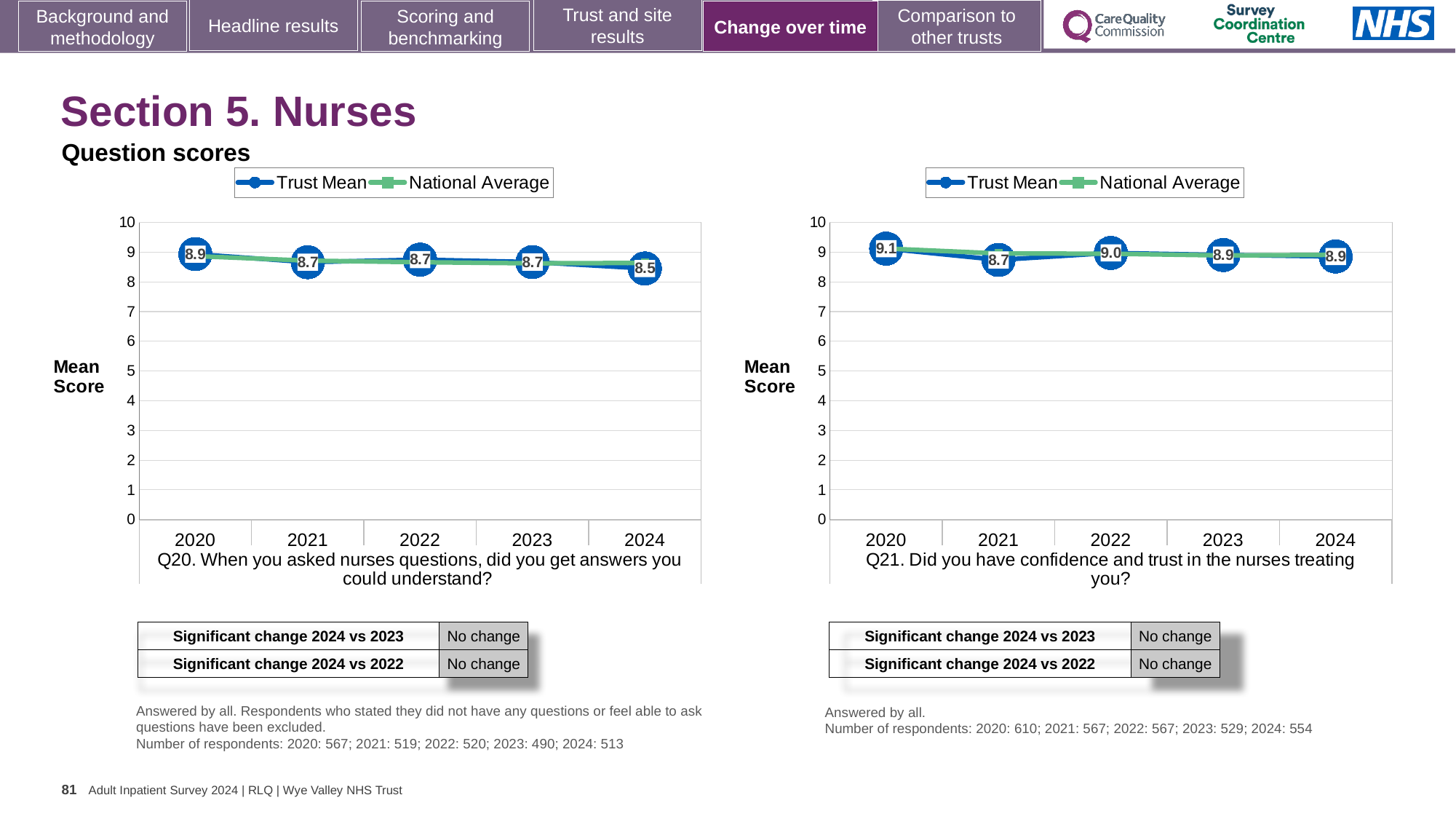
On the Q20 chart (left), what is the Trust Mean for 2024? 8.5 How many years are plotted on the Q20 chart (left)? 5 On the Q20 chart (left), what is the Trust Mean for 2020? 8.9 On the Q21 chart (right), what is the Trust Mean for 2022? 9.0 On the Q20 chart (left), what is the difference between the Trust Mean in 2020 and in 2024? 0.4 On the Q20 chart (left), which year has the lowest Trust Mean? 2024 What type of chart is used for the Q20 chart (left)? Line chart On the Q21 chart (right), what is the Trust Mean for 2020? 9.1 On the Q21 chart (right), is the Trust Mean for 2021 greater or less than 9? less How many series does the legend of the Q21 chart (right) list? 2 On the Q21 chart (right), which year has the highest Trust Mean? 2020 On the Q21 chart (right), is the Trust Mean higher in 2020 or in 2021? 2020